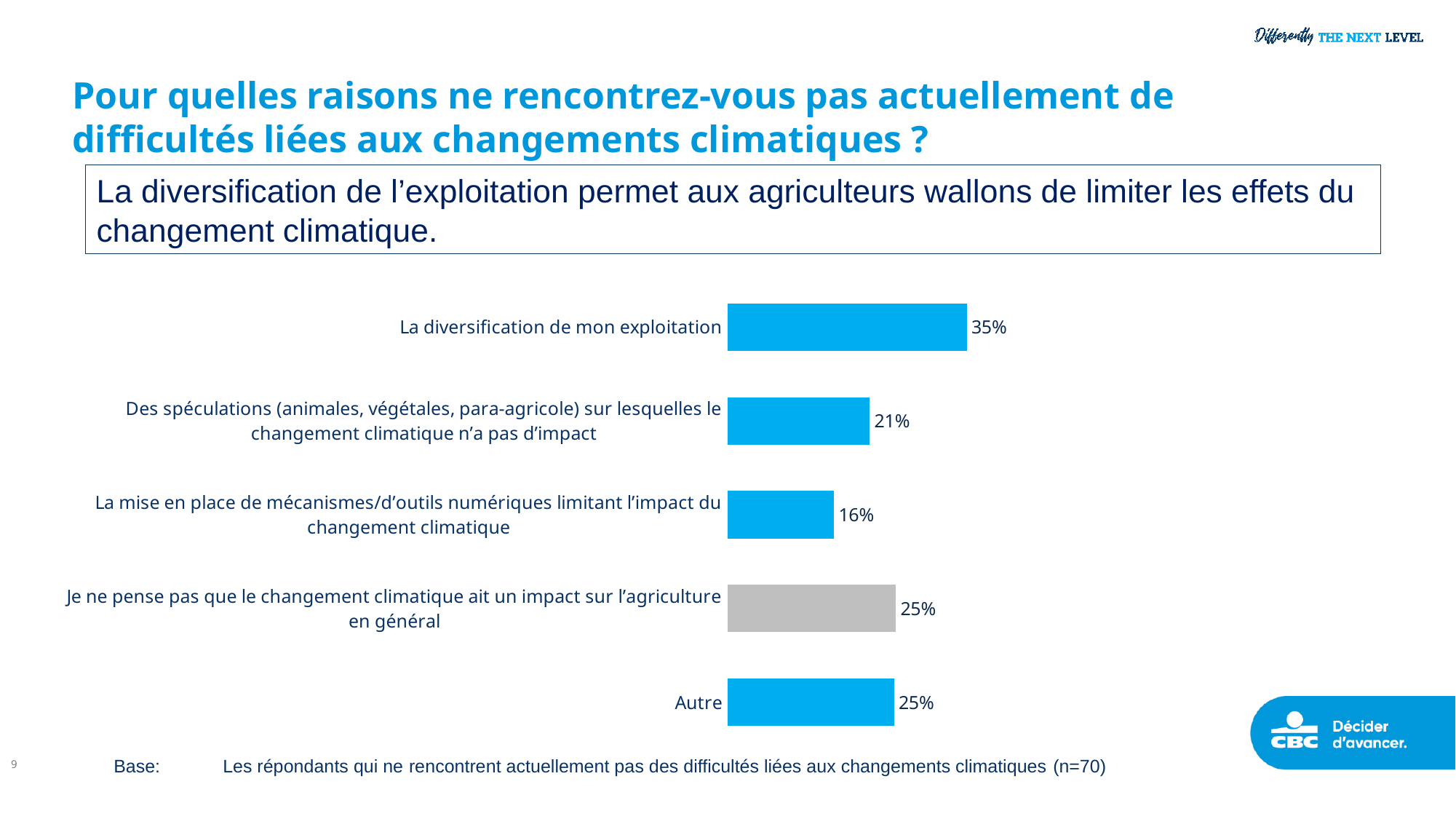
What is the value for "La mise en place de mécanismes/d'outils numériques limitant l'impact du changement climatique"? 16% Which category has the highest value? La diversification de mon exploitation What kind of chart is shown on the slide? Bar chart What is the value for "La diversification de mon exploitation"? 35% Which is larger: the value for "Je ne pense pas que le changement climatique ait un impact sur l'agriculture en général" or the value for "Des spéculations (animales, végétales, para-agricole) sur lesquelles le changement climatique n'a pas d'impact"? Je ne pense pas que le changement climatique ait un impact sur l'agriculture en général What is the value for "Des spéculations (animales, végétales, para-agricole) sur lesquelles le changement climatique n'a pas d'impact"? 21% What is the value for "Autre"? 25% What is the difference between "La diversification de mon exploitation" and "Autre"? 10% What is the difference between "Des spéculations (animales, végétales, para-agricole) sur lesquelles le changement climatique n'a pas d'impact" and "La mise en place de mécanismes/d'outils numériques limitant l'impact du changement climatique"? 5% Which category has the lowest value? La mise en place de mécanismes/d'outils numériques limitant l'impact du changement climatique Which category's bar is coloured grey instead of blue? Je ne pense pas que le changement climatique ait un impact sur l'agriculture en général How many categories are shown in the chart? 5